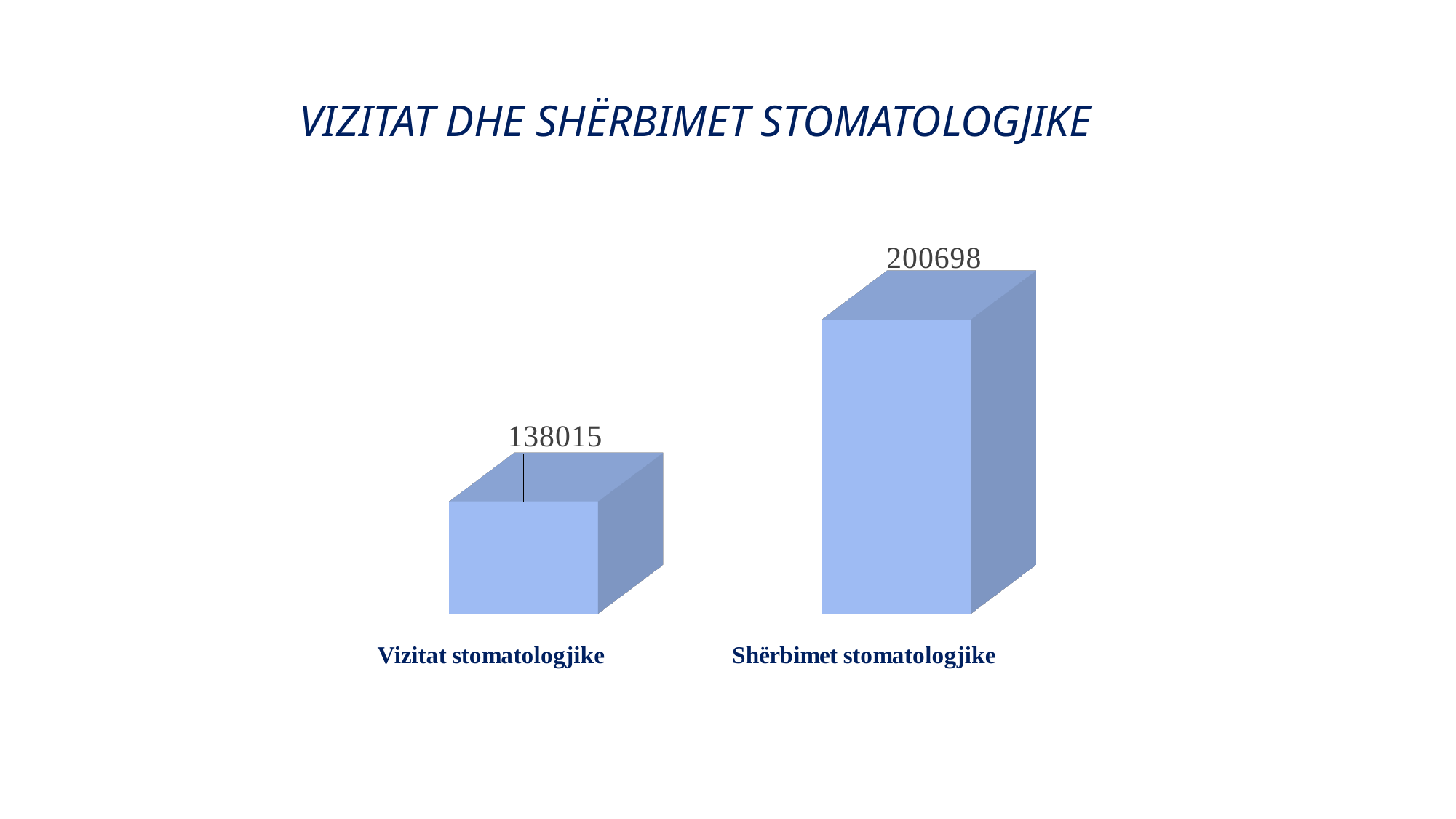
What is the total of the two values shown in the chart? 338713 What kind of chart is shown on the slide? Bar chart Which category has the lowest value? Vizitat stomatologjike How many categories are shown in the chart? 2 What colour are the bars in the chart? Blue Which is larger, the value for Vizitat stomatologjike or the value for Shërbimet stomatologjike? Shërbimet stomatologjike What is the title of the slide? VIZITAT DHE SHËRBIMET STOMATOLOGJIKE What is the value for Shërbimet stomatologjike? 200698 What is the value for Vizitat stomatologjike? 138015 Which category has the highest value? Shërbimet stomatologjike What is the difference between the values for Shërbimet stomatologjike and Vizitat stomatologjike? 62683